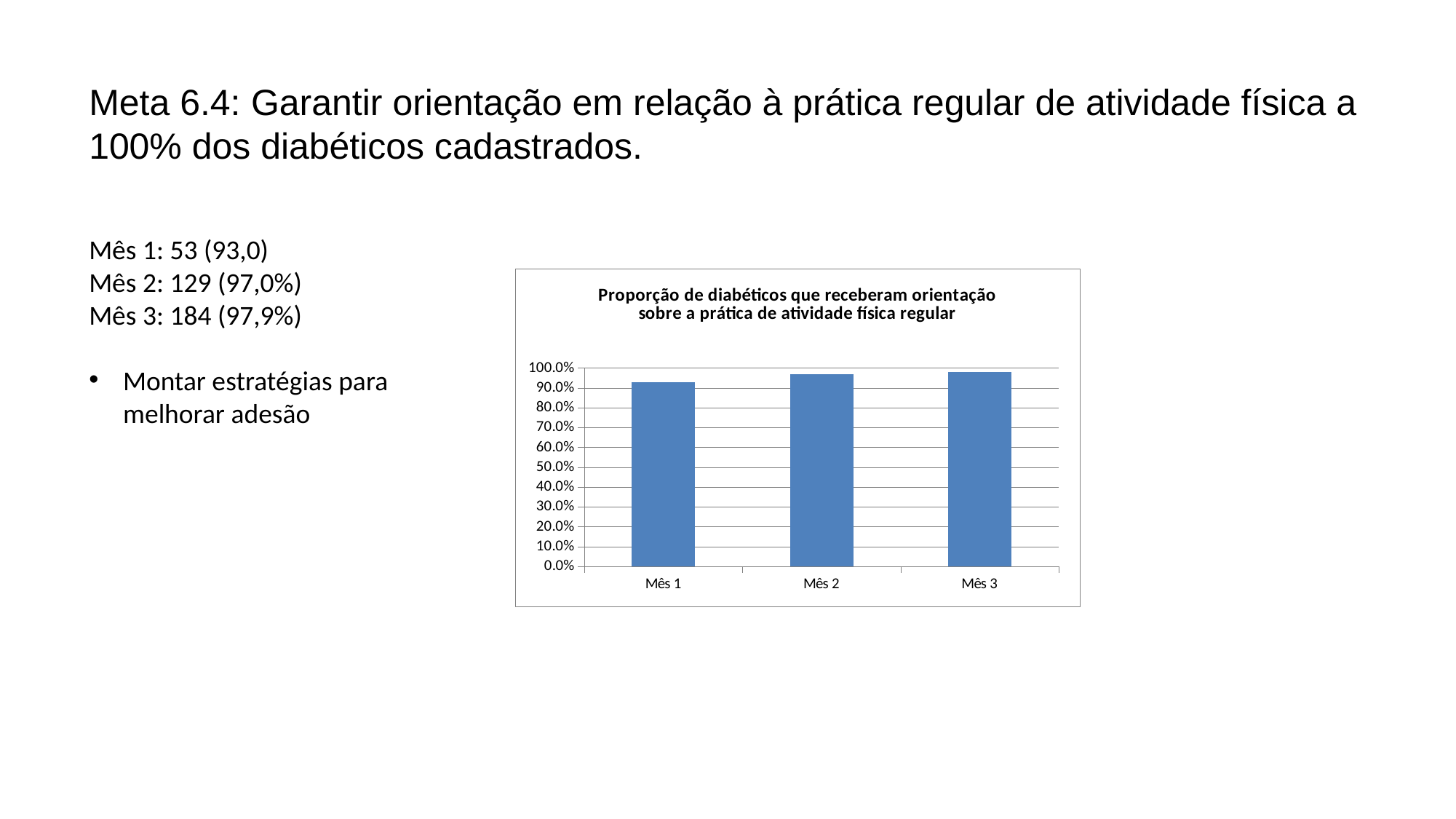
How many categories are plotted on the x axis of the chart? 3 Is the bar for Mês 2 greater or less than 100.0%? less What kind of chart is shown on the slide? bar chart Is the bar for Mês 3 greater or less than 90.0%? greater Which is larger, the bar for Mês 1 or the bar for Mês 3? Mês 3 Is the bar for Mês 1 greater or less than 80.0%? greater Do the values rise or fall from Mês 1 to Mês 3? rise According to the slide text, what proportion corresponds to Mês 3? 97,9% Which month has the lowest bar in the chart? Mês 1 What is the title of the chart? Proporção de diabéticos que receberam orientação sobre a prática de atividade física regular What is the highest value shown on the y axis of the chart? 100.0% According to the slide text, what proportion corresponds to Mês 2? 97,0%